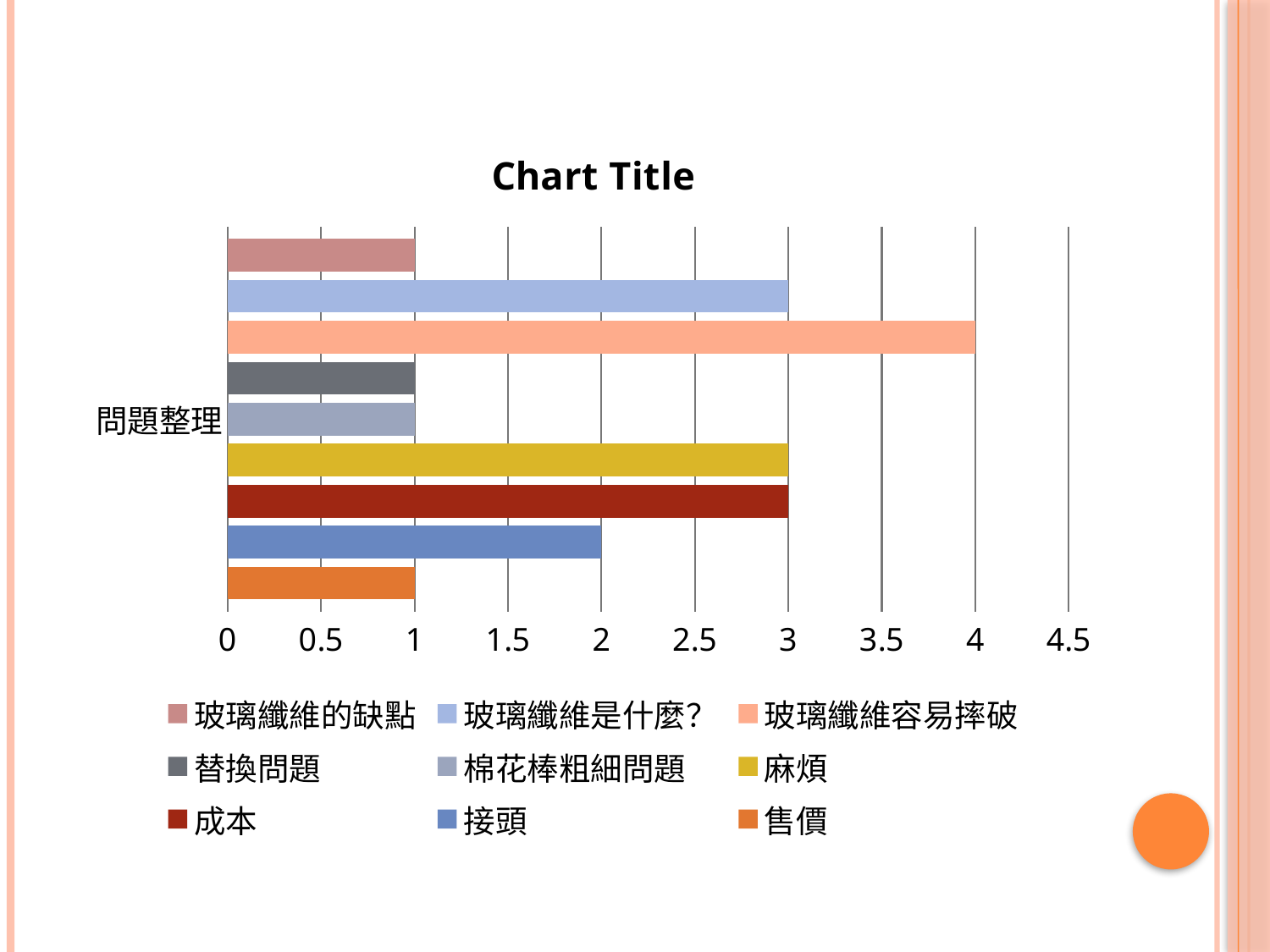
What is the value for 售價? 1 Which series has the highest value? 玻璃纖維容易摔破 What is the title of the chart? Chart Title How many series does the legend list? 9 What is the value for 玻璃纖維容易摔破? 4 What type of chart is shown on the slide? bar chart What is the difference between the values for 玻璃纖維容易摔破 and 接頭? 2 What is the value for 玻璃纖維是什麼? 3 Is the value for 成本 greater or less than 2? greater What is the value for 接頭? 2 Which is larger, the value for 麻煩 or the value for 替換問題? 麻煩 What is the category label shown on the vertical axis? 問題整理